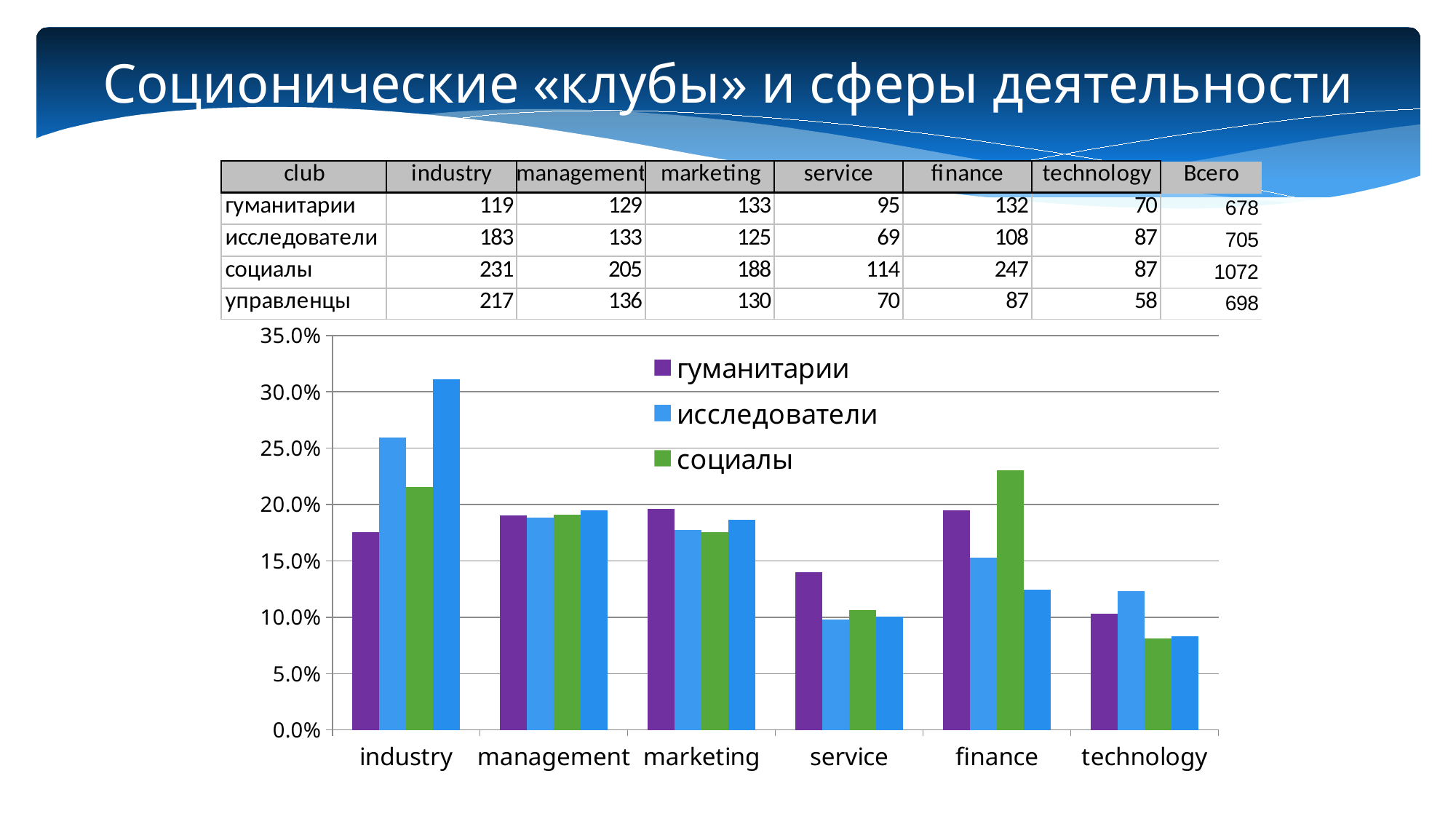
In the service category, which is larger: the bar for гуманитарии or the bar for исследователи? гуманитарии Is the value for социалы in finance greater or less than 20.0%? greater How many categories are shown along the x axis of the chart? 6 What colour represents the социалы series in the chart's legend? green In which category does the гуманитарии series have its lowest bar? technology Is the value for социалы in technology greater or less than 10.0%? less Is the value for гуманитарии in technology greater or less than 15.0%? less How many series does the chart's legend list? 3 What kind of chart is shown on the slide? bar chart In which category does the социалы series have its highest bar? finance